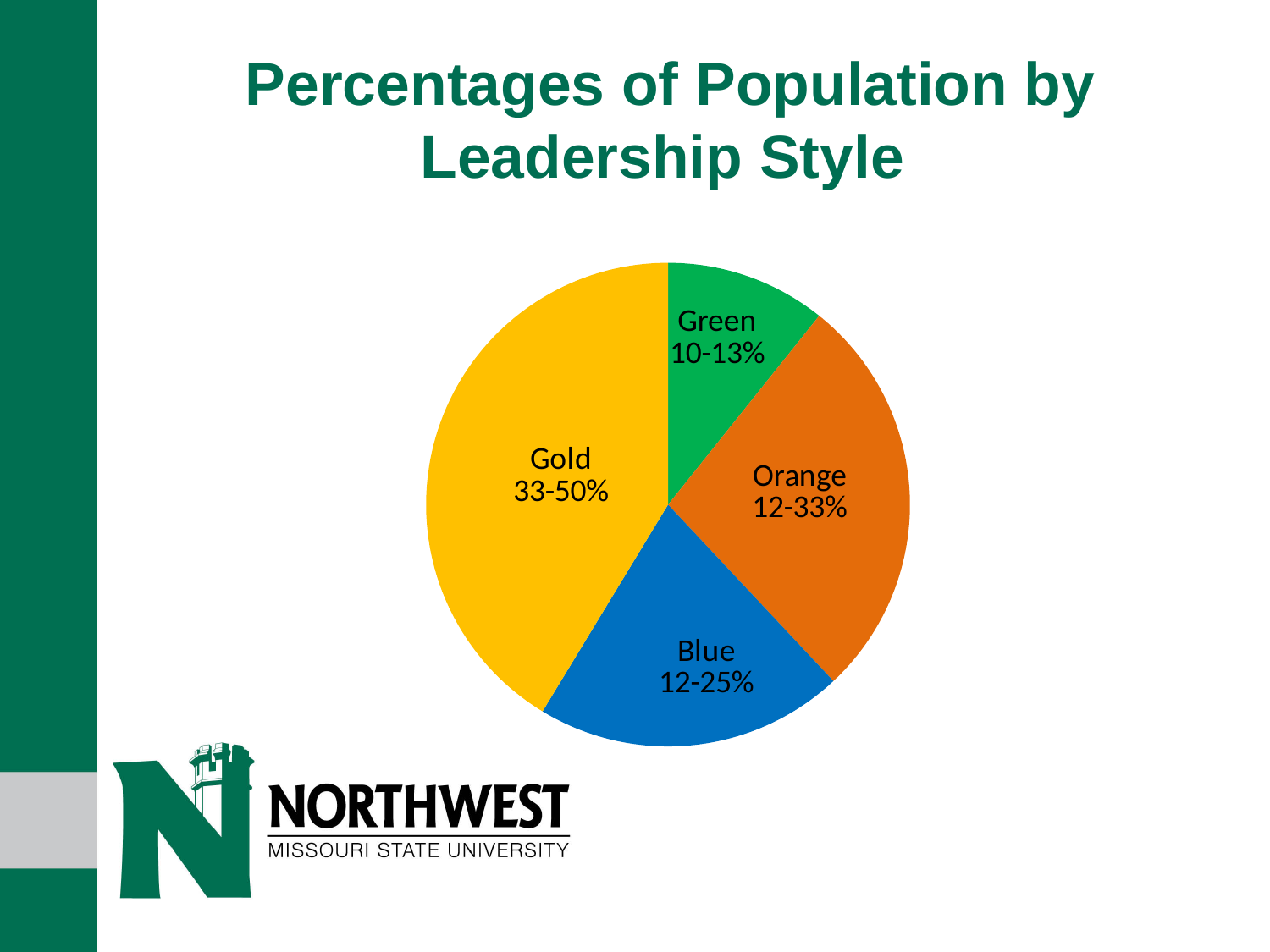
What percentage range is shown for the Blue leadership style? 12-25% What percentage range is shown for the Green leadership style? 10-13% What percentage range is shown for the Gold leadership style? 33-50% What percentage range is shown for the Orange leadership style? 12-33% Which slice is larger, Gold or Orange? Gold Which leadership style has the smallest slice of the pie? Green What is the title of the chart on the slide? Percentages of Population by Leadership Style Which slice is larger, Blue or Green? Blue What kind of chart is shown on the slide? Pie chart Which leadership styles are labelled on the pie chart? Green, Orange, Blue, Gold How many slices does the pie chart have? 4 Which leadership style has the largest slice of the pie? Gold